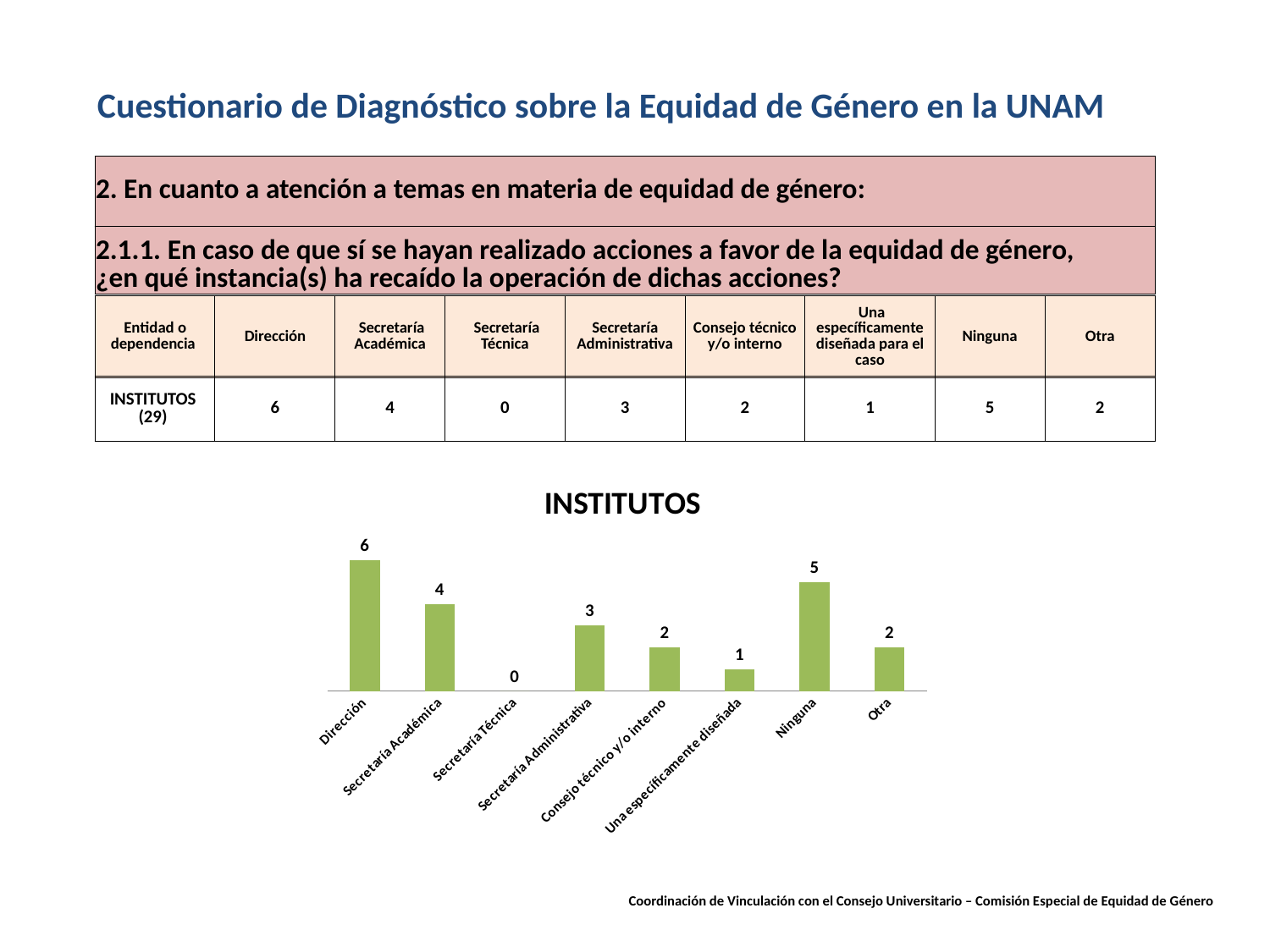
What kind of chart is the INSTITUTOS chart? Bar chart Which category has the highest value in the INSTITUTOS chart? Dirección What is the value for Ninguna in the INSTITUTOS chart? 5 What is the value for Secretaría Académica in the INSTITUTOS chart? 4 What is the difference between the values for Dirección and Ninguna in the INSTITUTOS chart? 1 What is the difference between the values for Secretaría Administrativa and Una específicamente diseñada in the INSTITUTOS chart? 2 Which category has the lowest value in the INSTITUTOS chart? Secretaría Técnica What is the value for Dirección in the INSTITUTOS chart? 6 What is the title of the chart on the slide? INSTITUTOS Which is larger in the INSTITUTOS chart, Secretaría Académica or Secretaría Administrativa? Secretaría Académica What is the value for Secretaría Técnica in the INSTITUTOS chart? 0 How many categories are shown in the INSTITUTOS chart? 8